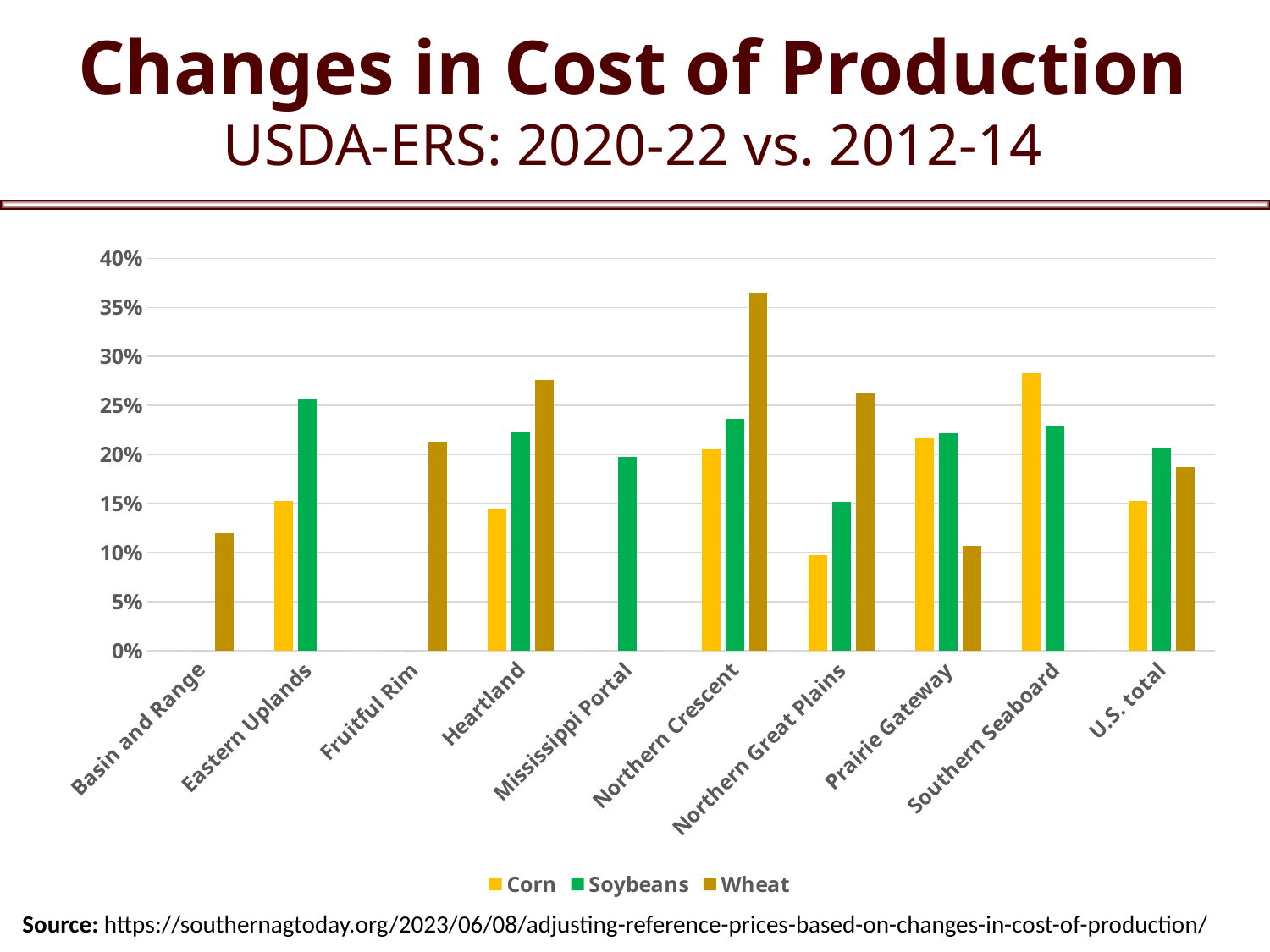
How many regions (categories) are shown on the x axis? 10 How many series does the legend list? 3 Which region has the highest Soybeans value? Eastern Uplands Which region has the lowest Corn value among those with a Corn bar? Northern Great Plains Is the Wheat value for Northern Crescent greater or less than 35%? greater Is the Wheat value for Basin and Range greater or less than 15%? less For Heartland, which is larger: the Wheat value or the Soybeans value? Wheat Which colour represents Soybeans in the legend? green Which region has the highest Wheat value? Northern Crescent What kind of chart is shown on the slide? bar chart Which region has the highest Corn value? Southern Seaboard Is the Corn value for Southern Seaboard greater or less than 25%? greater